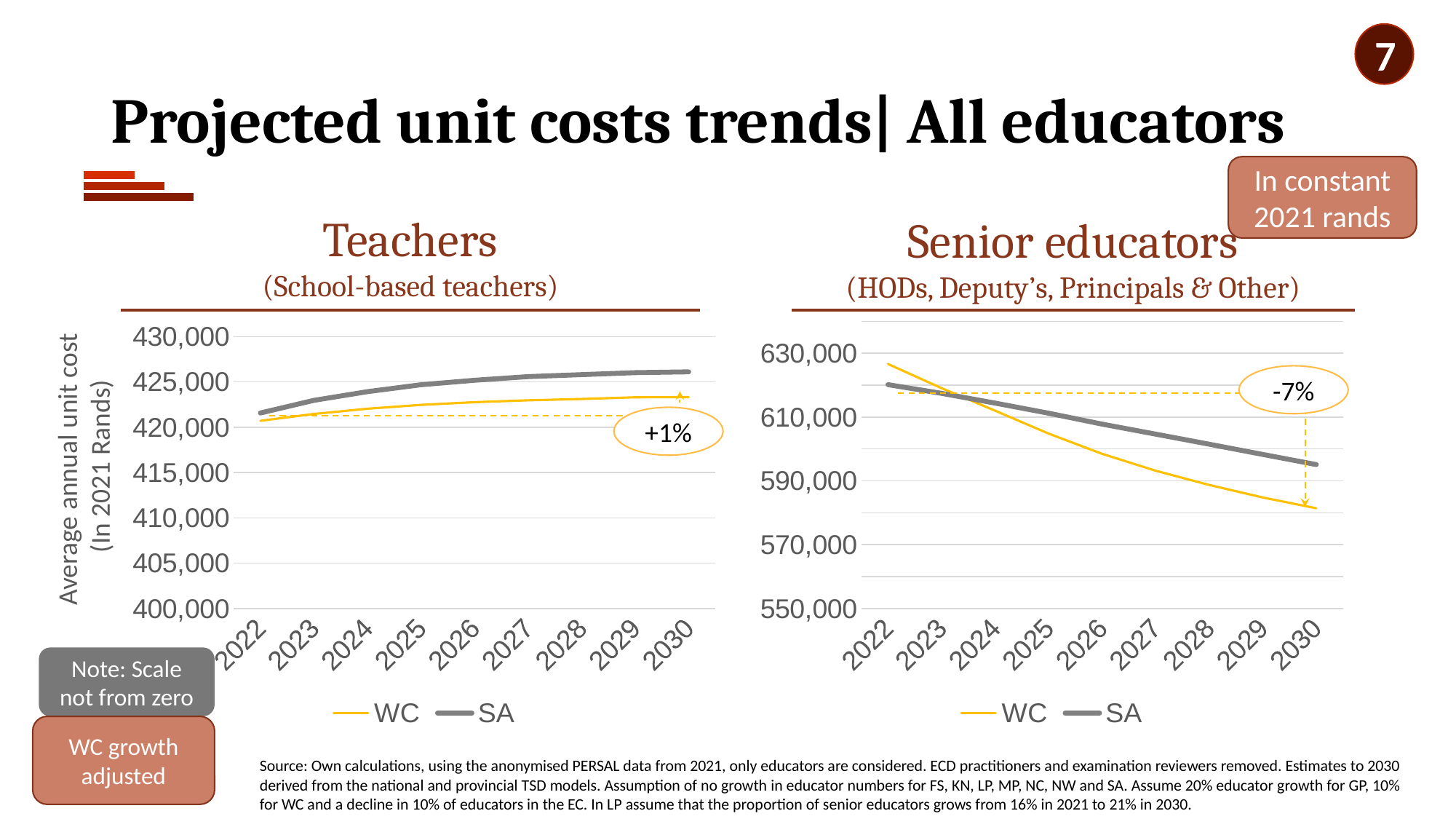
In the Senior educators chart, which series has the higher value in 2030, WC or SA? SA In the Senior educators chart, does the WC line rise or fall from 2022 to 2030? fall In the Senior educators chart, is the WC value for 2030 greater or less than 590,000? less In the Teachers chart, is the WC value for 2030 greater or less than 425,000? less What percentage change is annotated on the WC line in the Senior educators chart? -7% In the Teachers chart, does the SA line rise or fall from 2022 to 2030? rise What kind of chart is the Teachers chart? line chart In the Senior educators chart, is the WC value for 2022 greater or less than 620,000? greater How many years are plotted along the x axis of the Teachers chart? 9 How many series does the legend of the Senior educators chart list? 2 In the Senior educators chart, which series has the higher value in 2022, WC or SA? WC